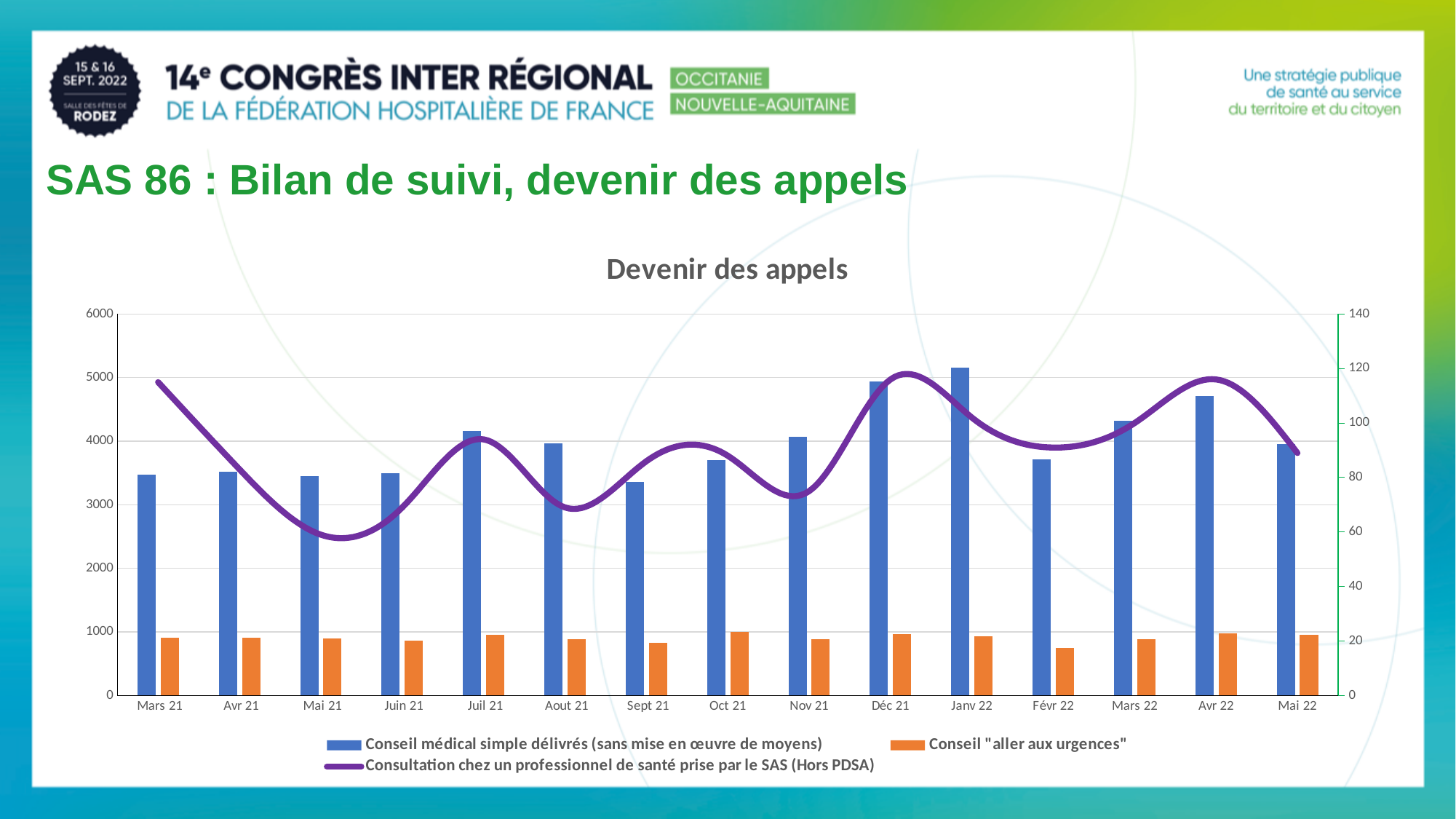
How many series does the chart legend list? 3 Is the value of the purple line for Mars 21 (right axis) greater or less than 100? greater Which series is drawn as the purple line? Consultation chez un professionnel de santé prise par le SAS (Hors PDSA) In which month does the purple line (Consultation chez un professionnel de santé) reach its lowest point? Mai 21 In which month is the blue bar (Conseil médical simple délivrés) highest? Janv 22 What is the title of the chart? Devenir des appels Does the blue bar series rise or fall from Nov 21 to Janv 22? rise Which month has the larger blue bar, Janv 22 or Févr 22? Janv 22 In which month is the orange bar (Conseil "aller aux urgences") lowest? Févr 22 Is the value of the blue bar for Janv 22 greater or less than 5000? greater How many months are shown on the x axis of the chart? 15 What kind of chart is shown on the slide? Combined bar and line chart